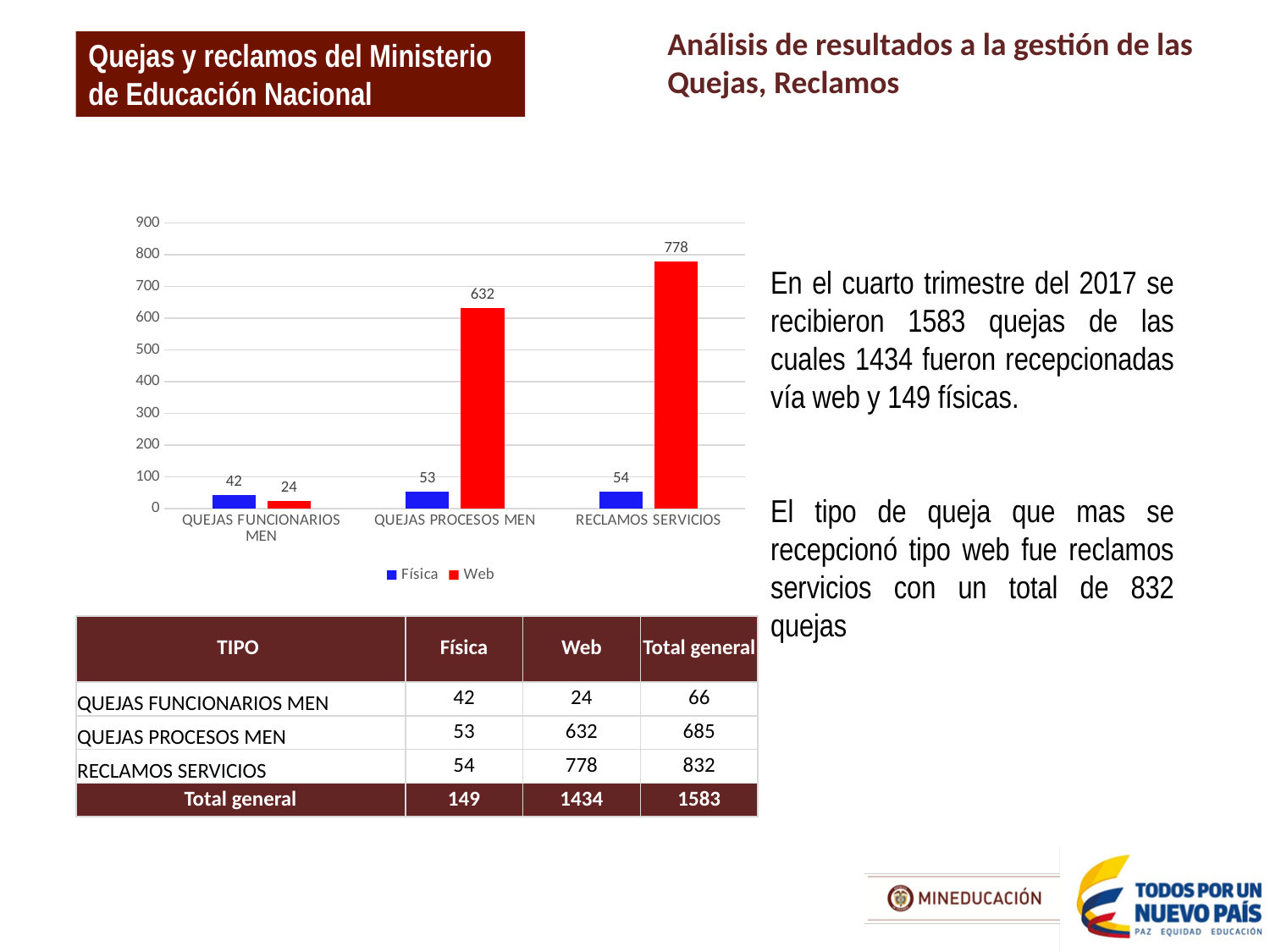
How many series does the chart legend list? 2 What is the Física value for RECLAMOS SERVICIOS? 54 What is the difference between the Web values for RECLAMOS SERVICIOS and QUEJAS PROCESOS MEN? 146 What kind of chart is shown on the slide? bar chart What is the Web value for QUEJAS PROCESOS MEN? 632 Is the Web value for RECLAMOS SERVICIOS greater or less than 700? greater Which category has the lowest Física value? QUEJAS FUNCIONARIOS MEN Which colour represents the Web series in the chart? red How many categories are shown on the x axis of the chart? 3 What is the Web value for QUEJAS FUNCIONARIOS MEN? 24 Which category has the highest Web value? RECLAMOS SERVICIOS Which is larger for QUEJAS FUNCIONARIOS MEN, the Física value or the Web value? Física